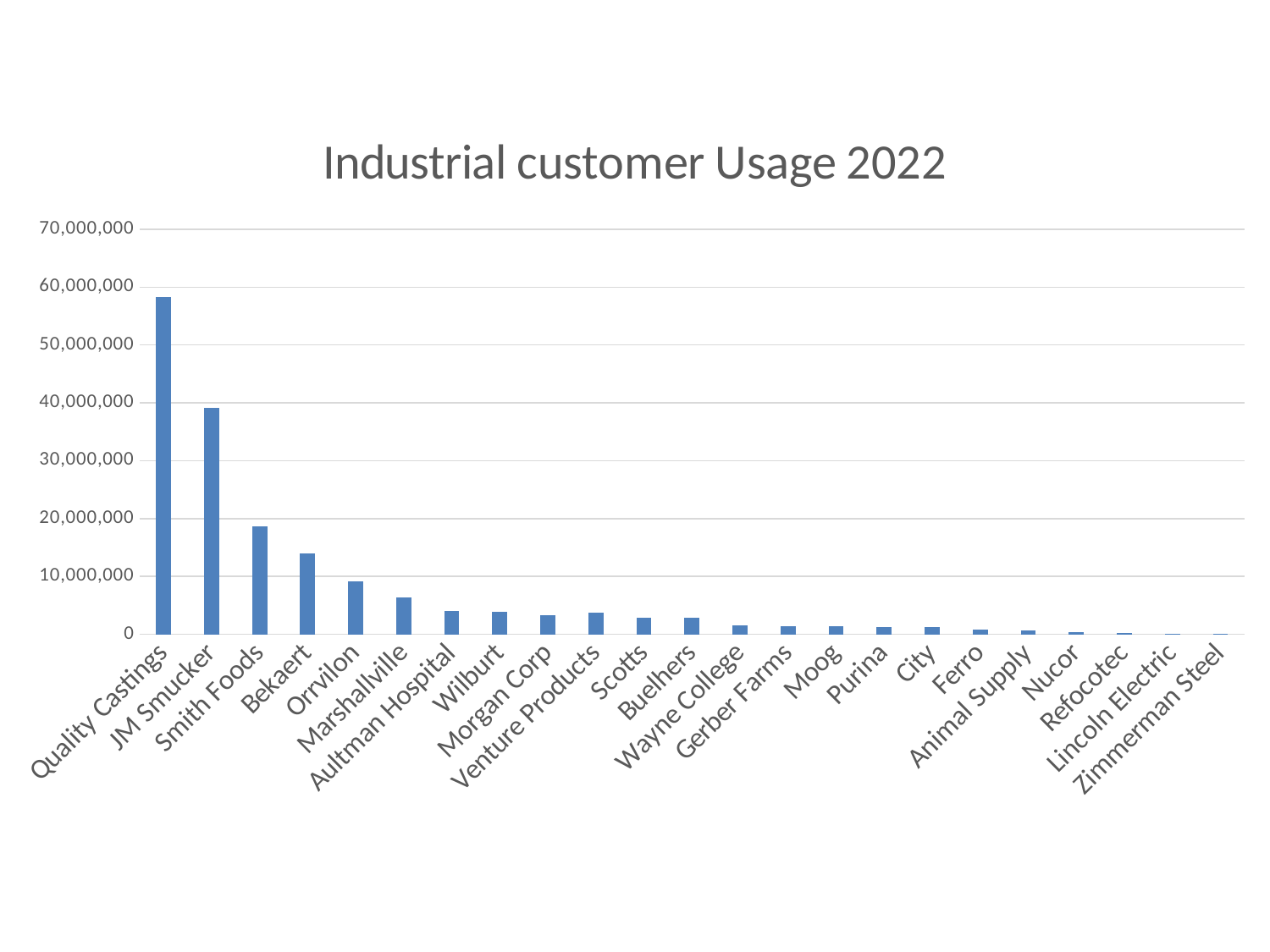
What is the title of the chart? Industrial customer Usage 2022 How many industrial customers are shown on the x axis? 23 Is the value for Quality Castings greater or less than 50,000,000? greater Which has the larger value, Marshallville or Aultman Hospital? Marshallville What kind of chart is shown on the slide? bar chart Is the value for Bekaert greater or less than 20,000,000? less Do the values generally rise or fall moving from left to right along the x axis? fall Which customer has the highest usage? Quality Castings Is the value for Smith Foods greater or less than 10,000,000? greater Which has the larger value, JM Smucker or Smith Foods? JM Smucker